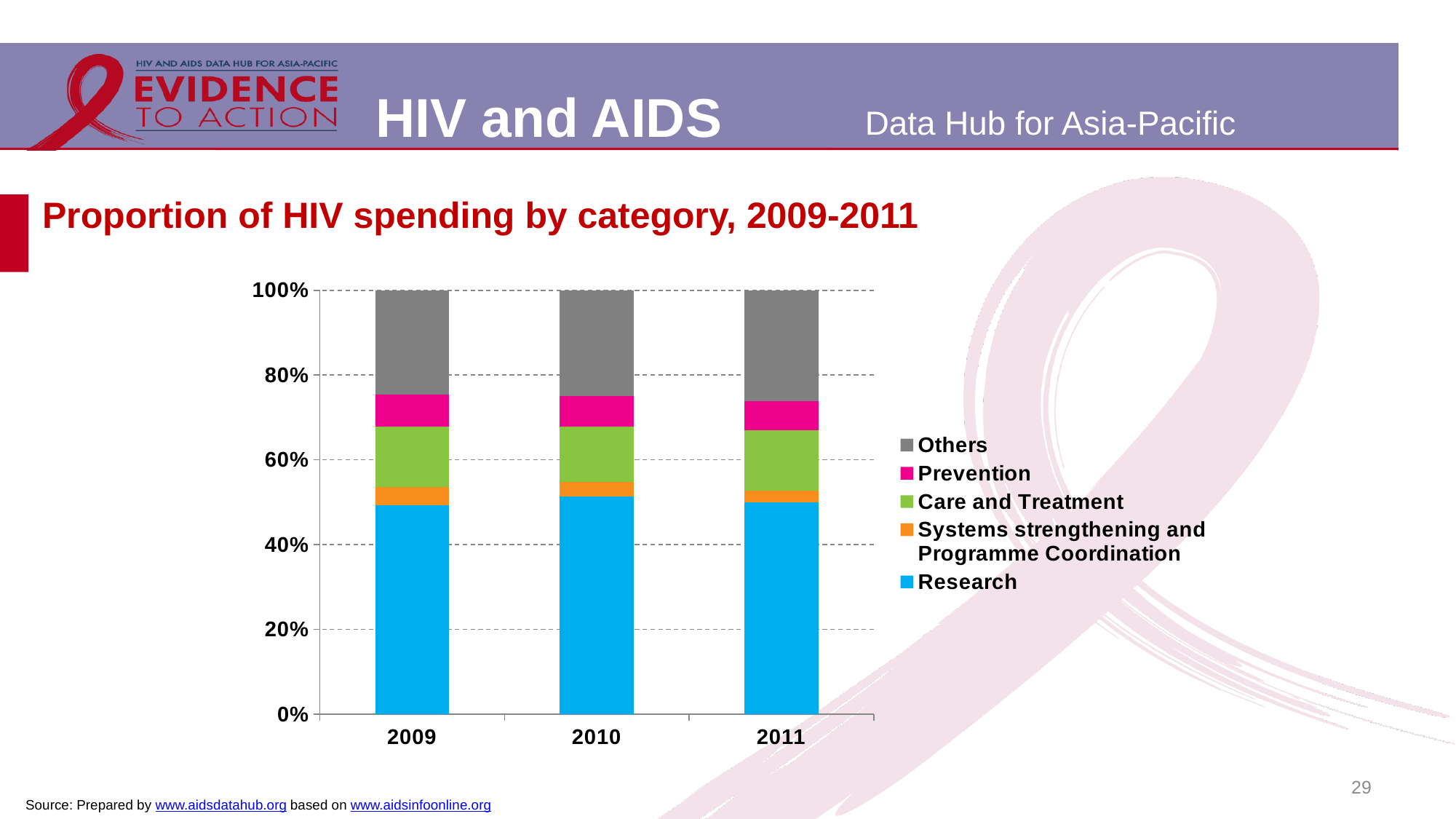
Is the share for Research in 2009 greater or less than 60%? less What do the segments of each stacked bar add up to? 100% How many years are shown on the x axis of the chart? 3 Which spending category has the largest share in 2009? Research Is the share for Research in 2011 greater or less than 40%? greater In 2010, which is larger: the share for Research or the share for Others? Research What kind of chart is shown on the slide? Stacked bar chart Which colour represents Research in the chart? Blue In 2009, which is larger: the share for Care and Treatment or the share for Prevention? Care and Treatment How many series does the chart legend list? 5 What is the title of the chart on the slide? Proportion of HIV spending by category, 2009-2011 Which spending category has the smallest share in 2011? Systems strengthening and Programme Coordination